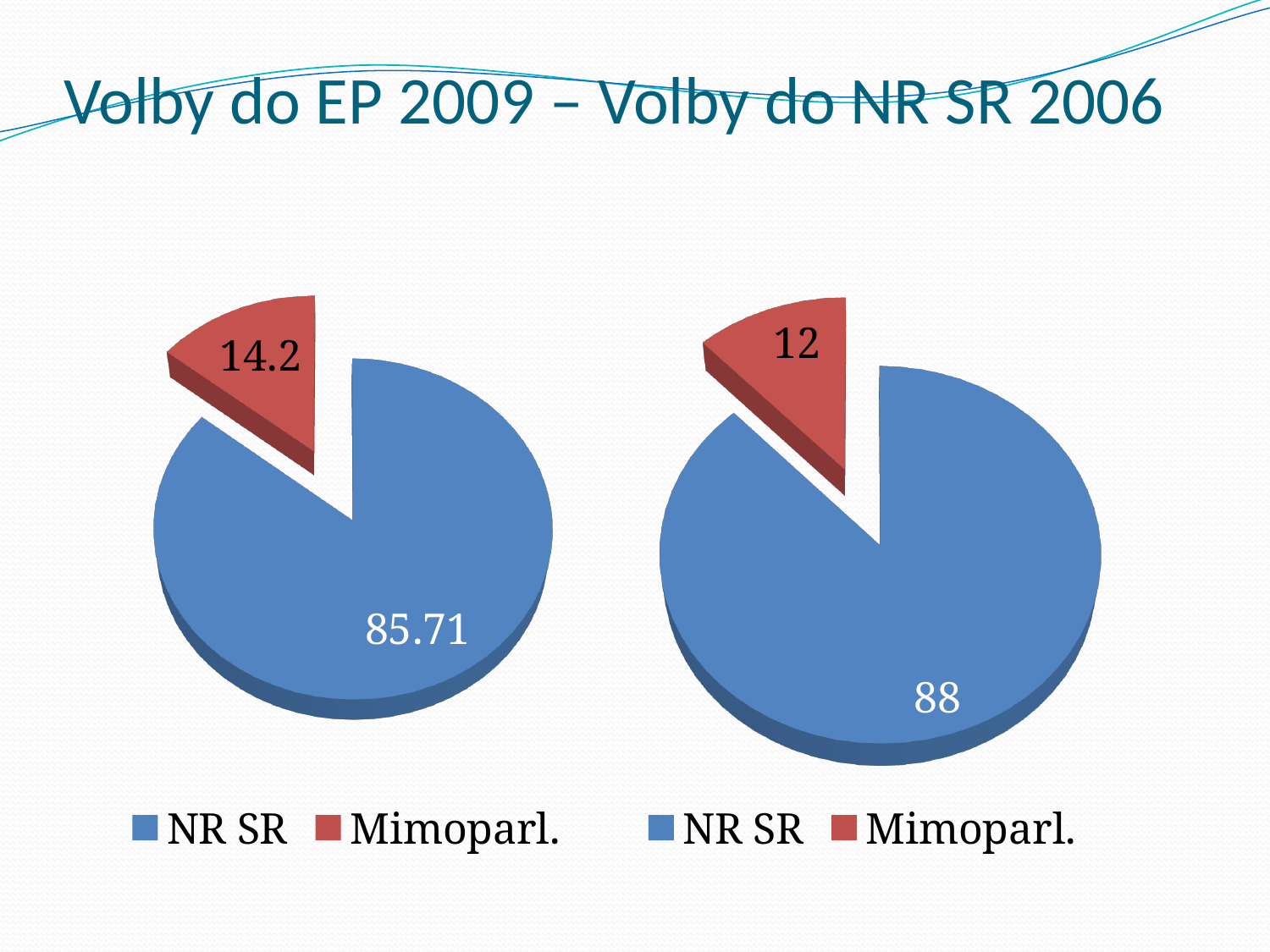
In the right pie chart, what is the value for Mimoparl.? 12 In the left pie chart, what is the difference between the NR SR value and the Mimoparl. value? 71.51 In the right pie chart, what colour is the Mimoparl. slice? red How many categories does the legend of the right pie chart list? 2 In the left pie chart, what is the value for Mimoparl.? 14.2 In the left pie chart, what is the value for NR SR? 85.71 In the right pie chart, which category has the smallest slice? Mimoparl. Is the NR SR value larger in the left pie chart or the right pie chart? right pie chart What type of chart is shown on the left of the slide? pie chart In the right pie chart, what is the value for NR SR? 88 In the right pie chart, what is the difference between the NR SR value and the Mimoparl. value? 76 In the left pie chart, which category has the largest slice? NR SR